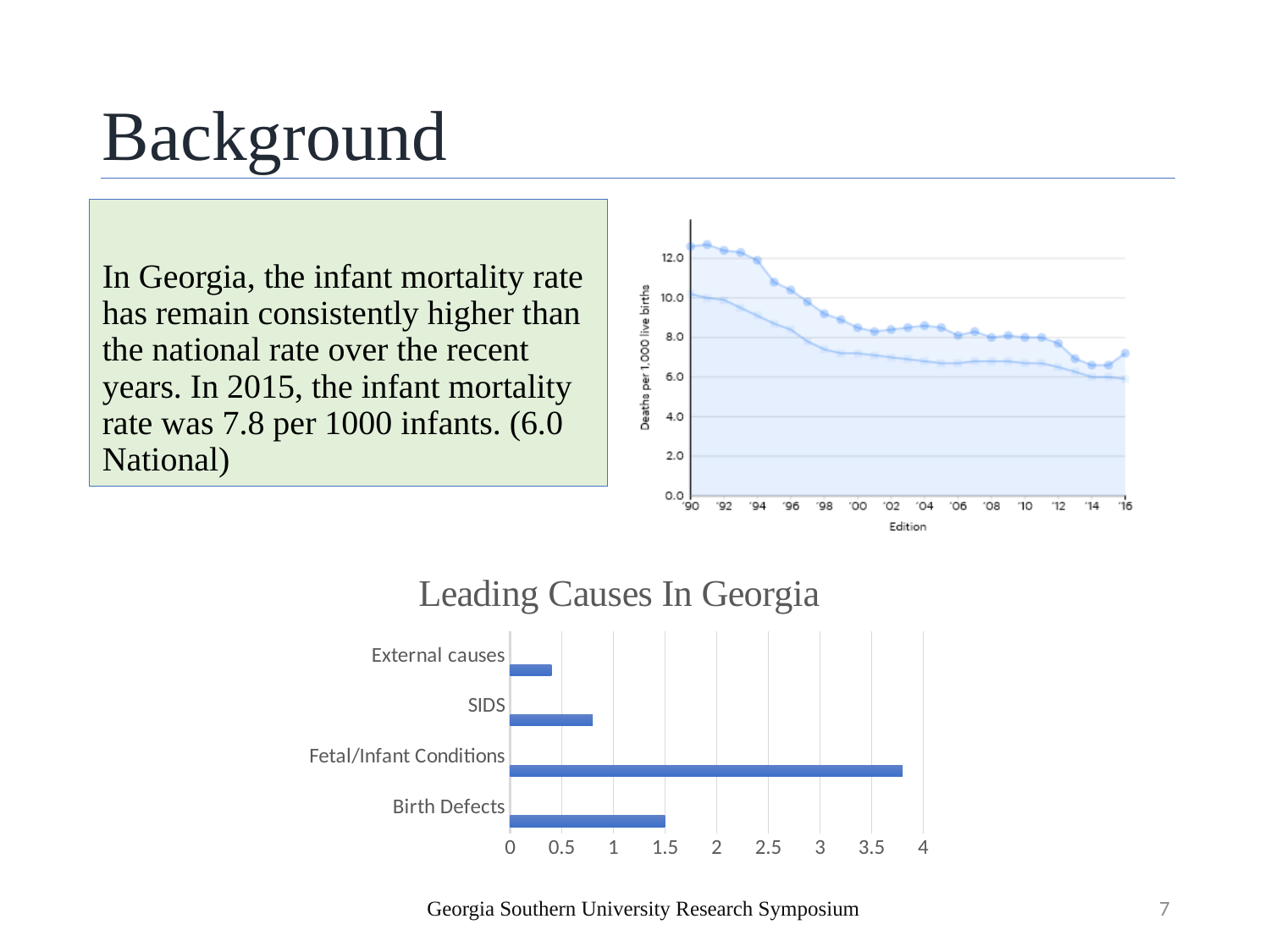
What is the y-axis label of the line chart at the top right of the slide? Deaths per 1,000 live births What kind of chart is the 'Leading Causes In Georgia' chart? bar chart What is the maximum value shown on the x axis of the 'Leading Causes In Georgia' chart? 4 In the 'Leading Causes In Georgia' chart, which category has the lowest value? External causes In the 'Leading Causes In Georgia' chart, which is larger, the value for Birth Defects or the value for SIDS? Birth Defects In the 'Leading Causes In Georgia' chart, is the value for External causes greater or less than 0.5? less What kind of chart is the chart at the top right of the slide? line chart In the 'Leading Causes In Georgia' chart, which category has the highest value? Fetal/Infant Conditions In the 'Leading Causes In Georgia' chart, is the value for SIDS greater or less than 1? less In the line chart at the top right of the slide, do the values generally rise or fall from '90 to '16? fall How many categories are shown in the 'Leading Causes In Georgia' chart? 4 In the 'Leading Causes In Georgia' chart, is the value for Fetal/Infant Conditions greater or less than 3.5? greater